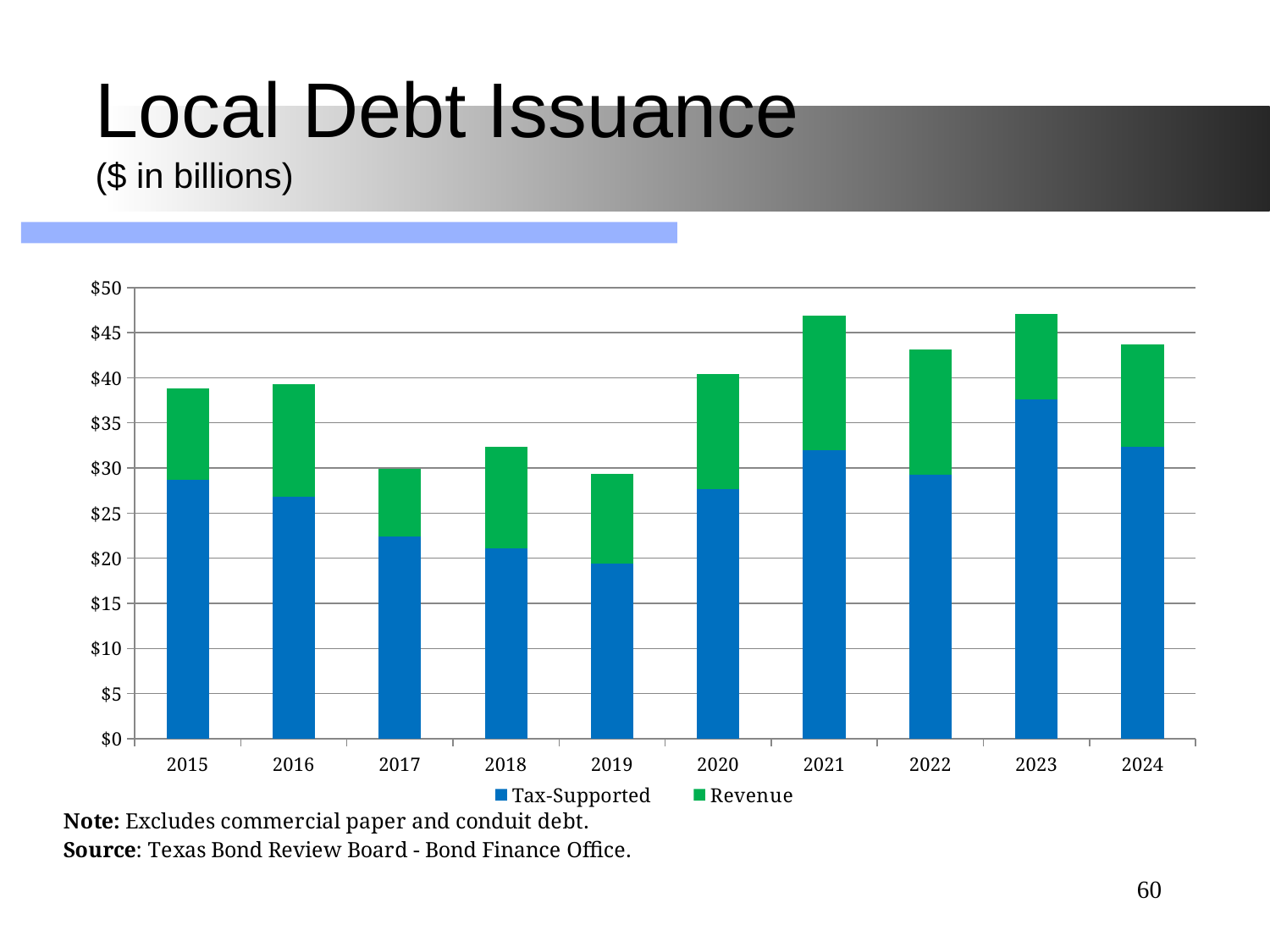
Is the total bar height for 2022 greater or less than $40? greater Which year has the highest Tax-Supported value? 2023 How many series does the legend list? 2 How many years are shown on the x axis of the chart? 10 Do the total bar heights rise or fall from 2019 to 2021? rise What kind of chart is shown on the slide? Stacked bar chart Which is larger, the total bar for 2015 or the total bar for 2017? 2015 Is the total bar height for 2021 greater or less than $45? greater Is the Tax-Supported value for 2015 greater or less than $30? less What are the two series named in the legend? Tax-Supported and Revenue Which year has the lowest Tax-Supported value? 2019